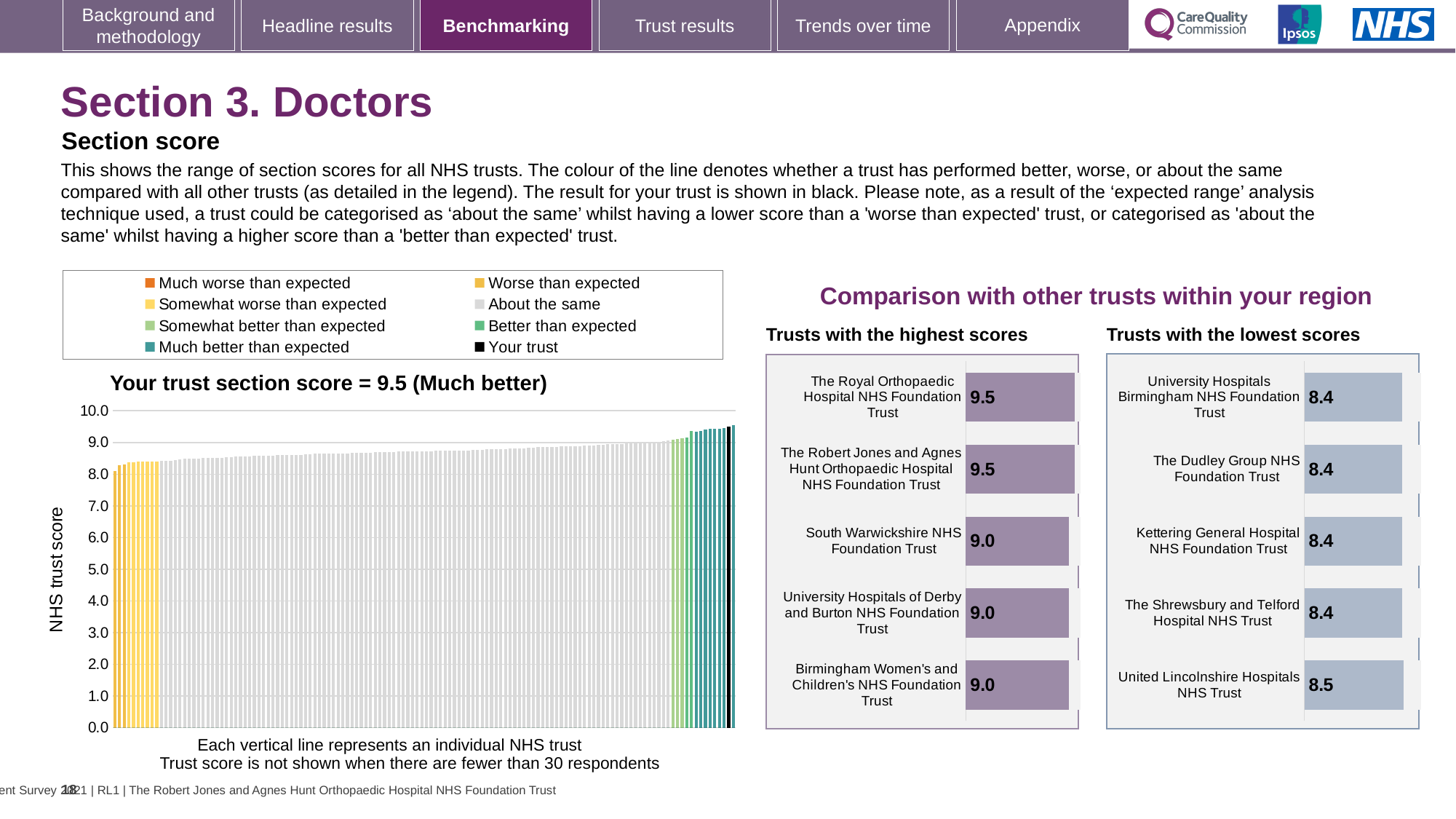
In the 'Your trust section score' chart, what is the section score for your trust? 9.5 In the 'Trusts with the lowest scores' chart, what is the score for Kettering General Hospital NHS Foundation Trust? 8.4 In the 'Trusts with the lowest scores' chart, which trust has the highest score? United Lincolnshire Hospitals NHS Trust In the 'Your trust section score' chart, do the bar values rise or fall from left to right along the x axis? rise In the 'Trusts with the lowest scores' chart, which is larger: the score for United Lincolnshire Hospitals NHS Trust or the score for The Dudley Group NHS Foundation Trust? United Lincolnshire Hospitals NHS Trust What kind of chart is the 'Your trust section score' chart on the left of the slide? bar chart In the 'Trusts with the highest scores' chart, how many trusts are listed? 5 In the 'Trusts with the highest scores' chart, what is the score for South Warwickshire NHS Foundation Trust? 9.0 In the 'Trusts with the highest scores' chart, what is the score for The Royal Orthopaedic Hospital NHS Foundation Trust? 9.5 What is the label on the y axis of the 'Your trust section score' chart? NHS trust score In the 'Trusts with the highest scores' chart, what is the difference between the score for The Robert Jones and Agnes Hunt Orthopaedic Hospital NHS Foundation Trust and the score for Birmingham Women's and Children's NHS Foundation Trust? 0.5 How many entries does the legend above the 'Your trust section score' chart list? 8